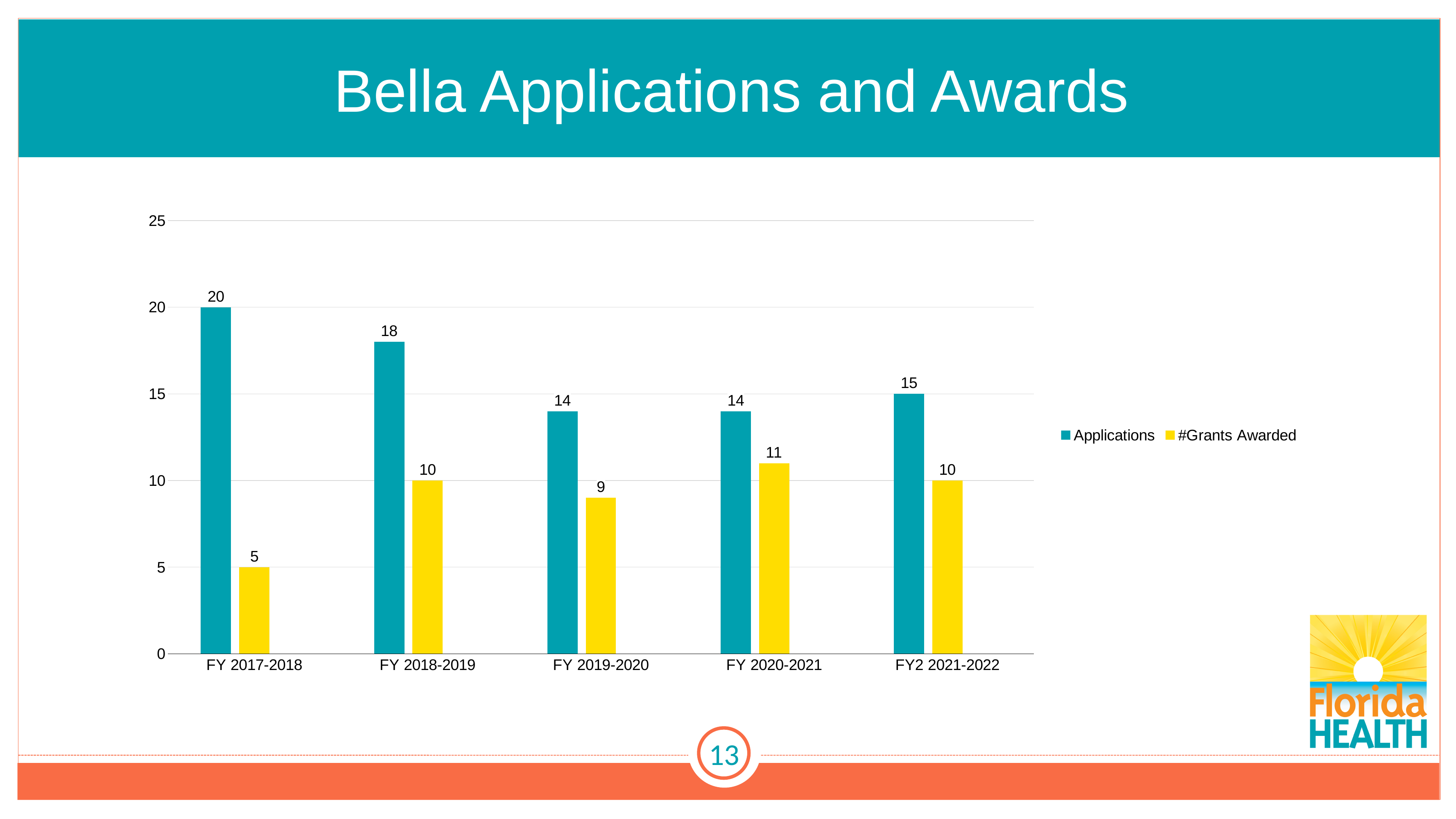
Which fiscal year had the lowest number of grants awarded? FY 2017-2018 How many Applications were there in FY2 2021-2022? 15 What colour are the #Grants Awarded bars? Yellow What kind of chart is shown on the slide? Bar chart What is the difference between Applications and grants awarded in FY 2018-2019? 8 How many fiscal years are shown on the x axis? 5 How many series does the legend list? 2 How many grants were awarded in FY 2019-2020? 9 How many Applications were there in FY 2017-2018? 20 Which fiscal year had the highest number of grants awarded? FY 2020-2021 Which fiscal year had the highest number of Applications? FY 2017-2018 Which is larger: Applications in FY 2018-2019 or Applications in FY2 2021-2022? Applications in FY 2018-2019